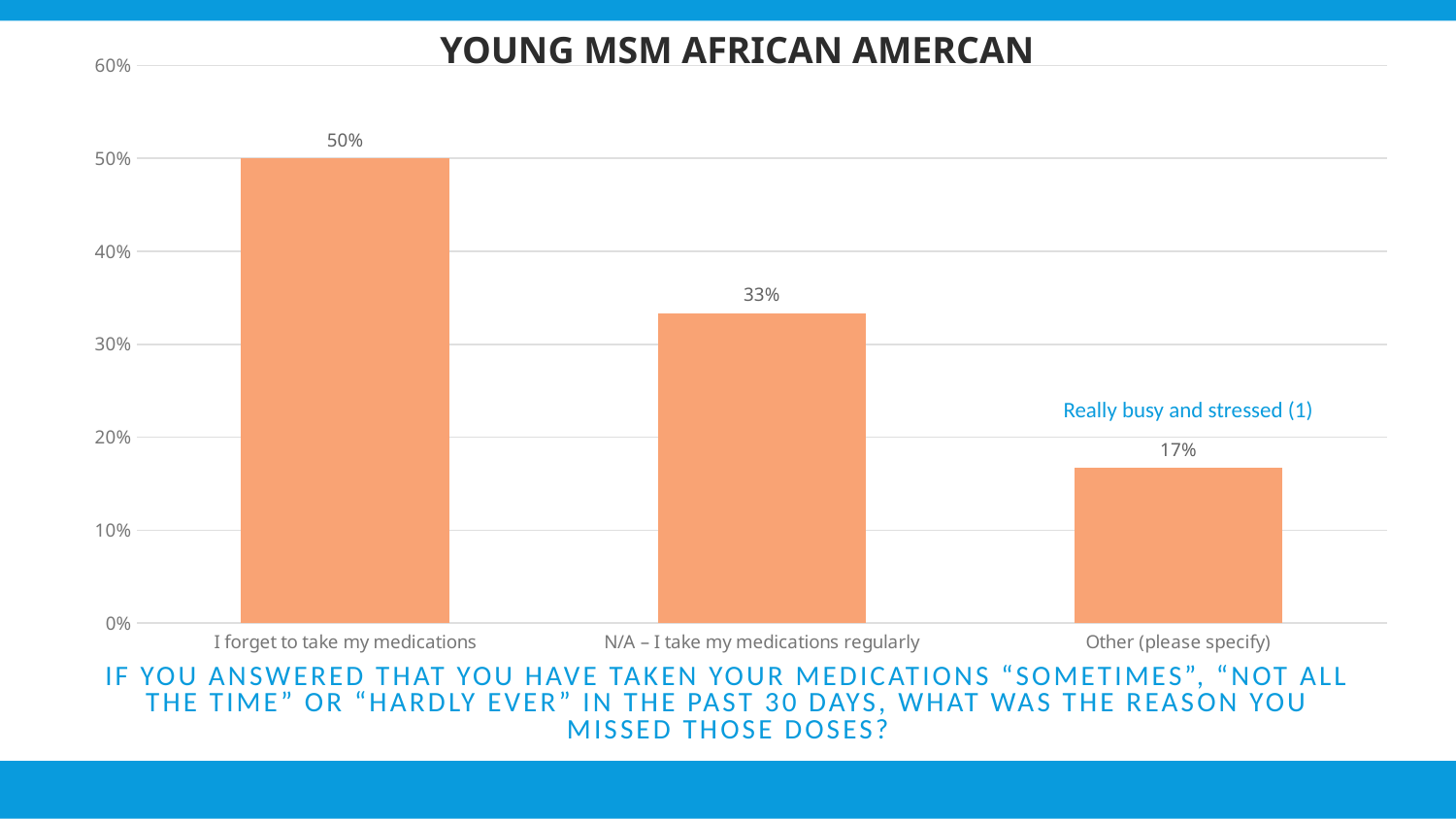
What is the difference between the values for "I forget to take my medications" and "N/A – I take my medications regularly"? 17% Which category has the lowest value? Other (please specify) Which category has the highest value? I forget to take my medications What is the value for "N/A – I take my medications regularly"? 33% What kind of chart is shown on the slide? bar chart How many categories are shown in the chart? 3 Is the value for "N/A – I take my medications regularly" greater or less than 40%? less What is the title of the chart? YOUNG MSM AFRICAN AMERCAN Which is larger, the value for "N/A – I take my medications regularly" or the value for "Other (please specify)"? N/A – I take my medications regularly What is the value for "Other (please specify)"? 17% What is the difference between the values for "I forget to take my medications" and "Other (please specify)"? 33% What is the value for "I forget to take my medications"? 50%